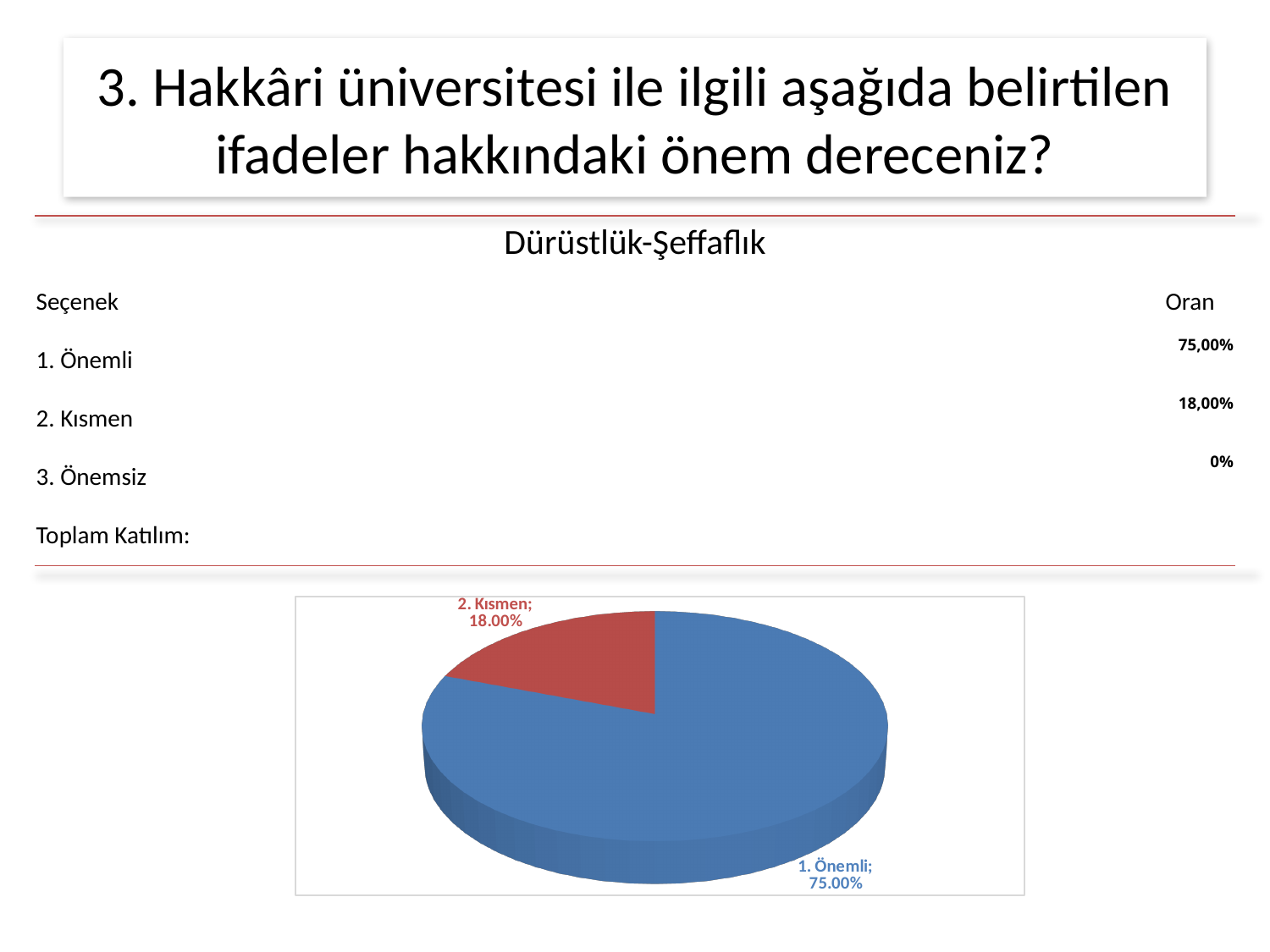
What percentage does the pie chart show for "2. Kısmen"? 18.00% What percentage does the pie chart show for "1. Önemli"? 75.00% Which is larger in the pie chart, "1. Önemli" or "2. Kısmen"? 1. Önemli What colour is the "1. Önemli" slice in the pie chart? blue Which labeled slice in the pie chart is the smallest? 2. Kısmen What is the difference between the "1. Önemli" and "2. Kısmen" slices in the pie chart? 57.00% What share of the pie does the "2. Kısmen" slice represent? 18.00% What kind of chart is shown on the slide? pie chart How many labeled slices does the pie chart have? 2 Which category has the largest slice in the pie chart? 1. Önemli What colour is the "2. Kısmen" slice in the pie chart? red